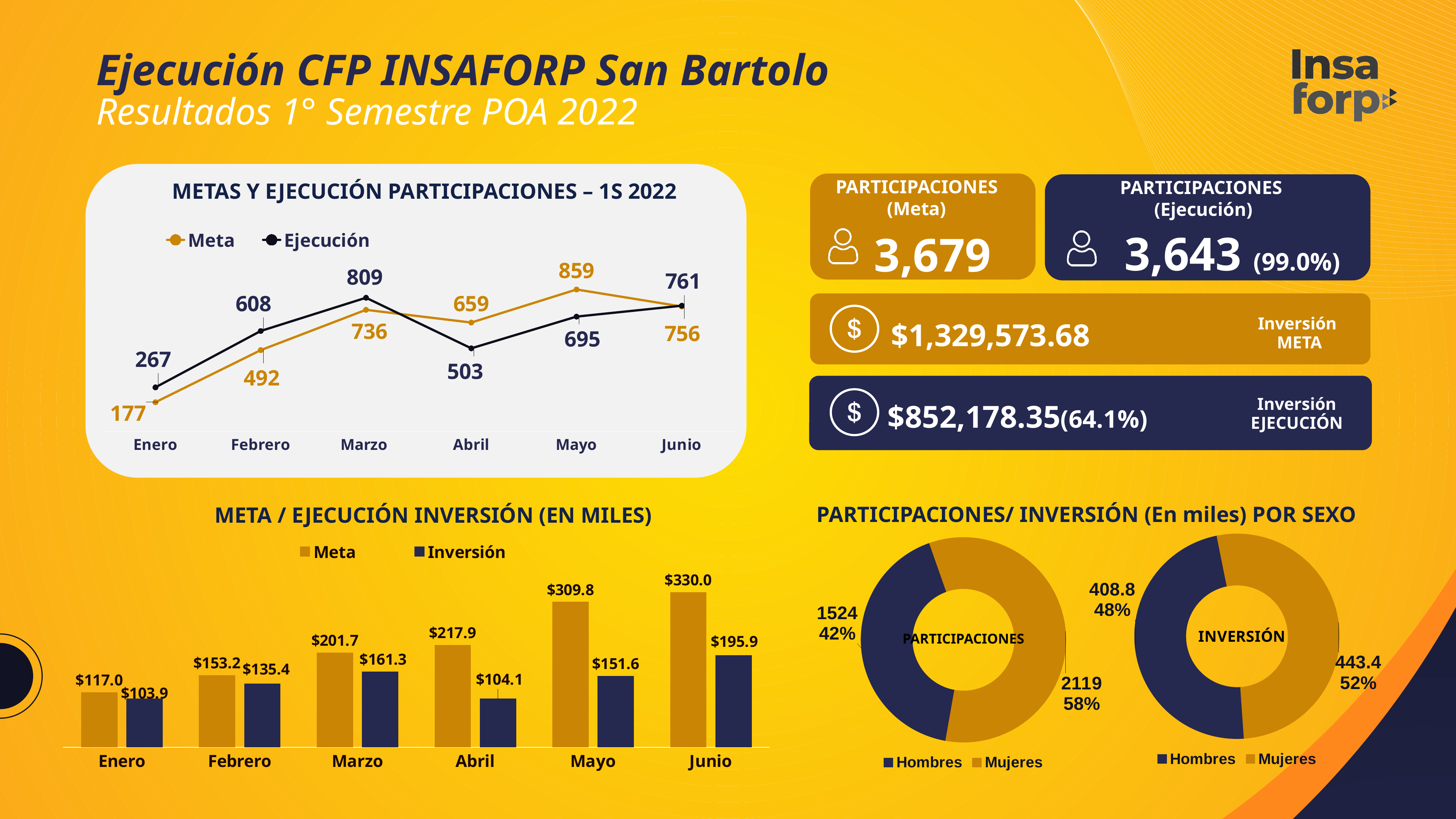
In the 'METAS Y EJECUCIÓN PARTICIPACIONES – 1S 2022' line chart, what is the Ejecución value for Marzo? 809 In the 'METAS Y EJECUCIÓN PARTICIPACIONES – 1S 2022' line chart, what is the difference between the Ejecución and Meta values for Enero? 90 In the 'INVERSIÓN' donut chart, what is the value for Hombres? 408.8 In the 'PARTICIPACIONES' donut chart, what share of participations corresponds to Mujeres? 58% In the 'META / EJECUCIÓN INVERSIÓN (EN MILES)' bar chart, which month has the highest Meta value? Junio What kind of chart is 'META / EJECUCIÓN INVERSIÓN (EN MILES)'? Bar chart In the 'METAS Y EJECUCIÓN PARTICIPACIONES – 1S 2022' line chart, what is the Meta value for Mayo? 859 How many series does the legend of the 'METAS Y EJECUCIÓN PARTICIPACIONES – 1S 2022' chart list? 2 In the 'META / EJECUCIÓN INVERSIÓN (EN MILES)' bar chart, how many months are shown on the x axis? 6 In the 'METAS Y EJECUCIÓN PARTICIPACIONES – 1S 2022' line chart, which is larger for Abril, Meta or Ejecución? Meta In the 'META / EJECUCIÓN INVERSIÓN (EN MILES)' bar chart, what is the Inversión value for Abril? $104.1 In the 'METAS Y EJECUCIÓN PARTICIPACIONES – 1S 2022' line chart, which month has the lowest Meta value? Enero